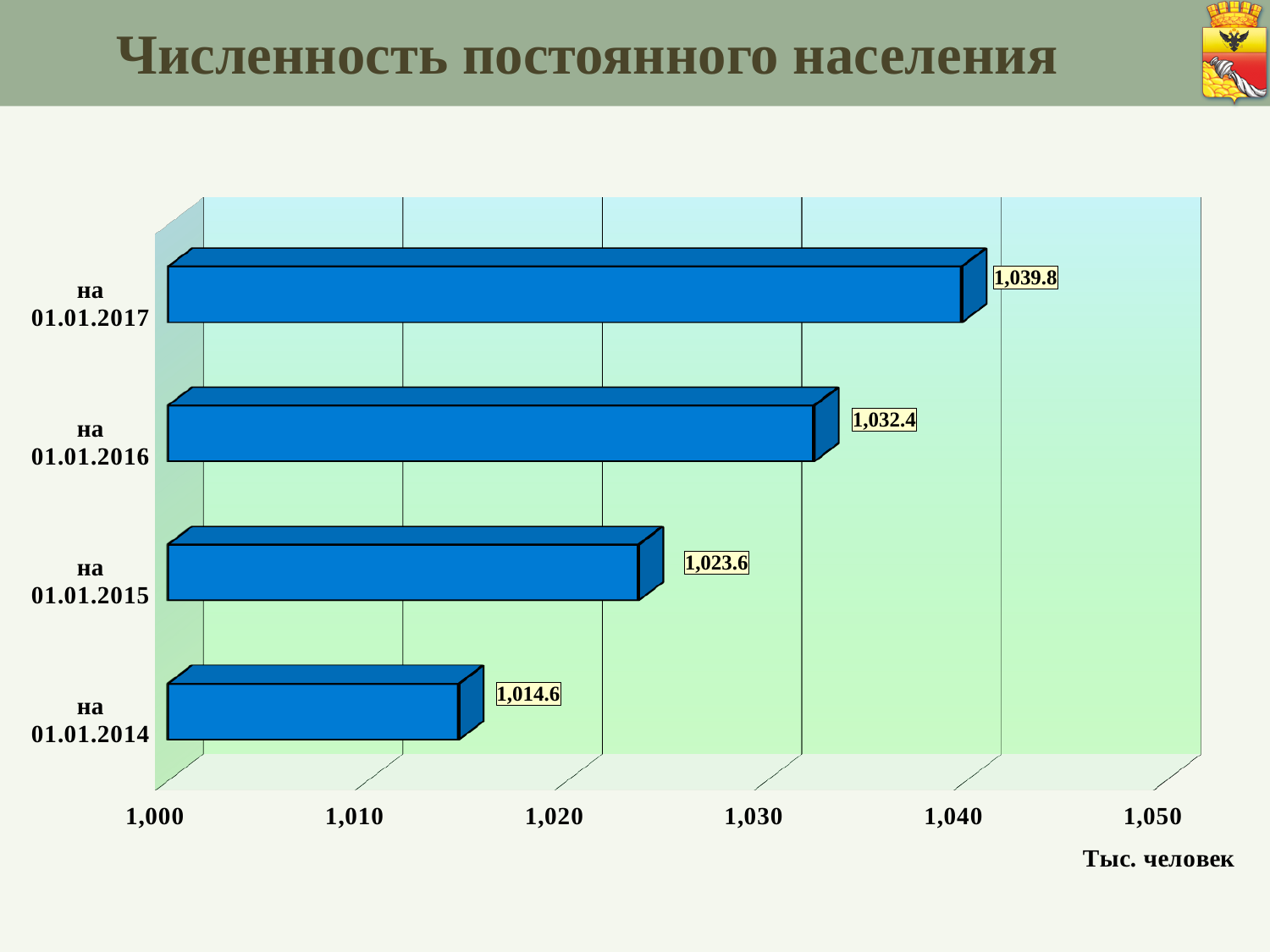
What is the difference between the values for на 01.01.2017 and на 01.01.2016? 7.4 What is the value for на 01.01.2014? 1,014.6 What kind of chart is shown on the slide? bar chart What is the difference between the values for на 01.01.2015 and на 01.01.2014? 9.0 How many dates are shown on the chart? 4 Which date has the lowest value? на 01.01.2014 Which is larger, the value for на 01.01.2016 or на 01.01.2015? на 01.01.2016 Which date has the highest value? на 01.01.2017 What is the value for на 01.01.2015? 1,023.6 Is the value for на 01.01.2016 greater or less than 1,030? greater What is the value for на 01.01.2017? 1,039.8 What unit is indicated below the axis of the chart? Тыс. человек